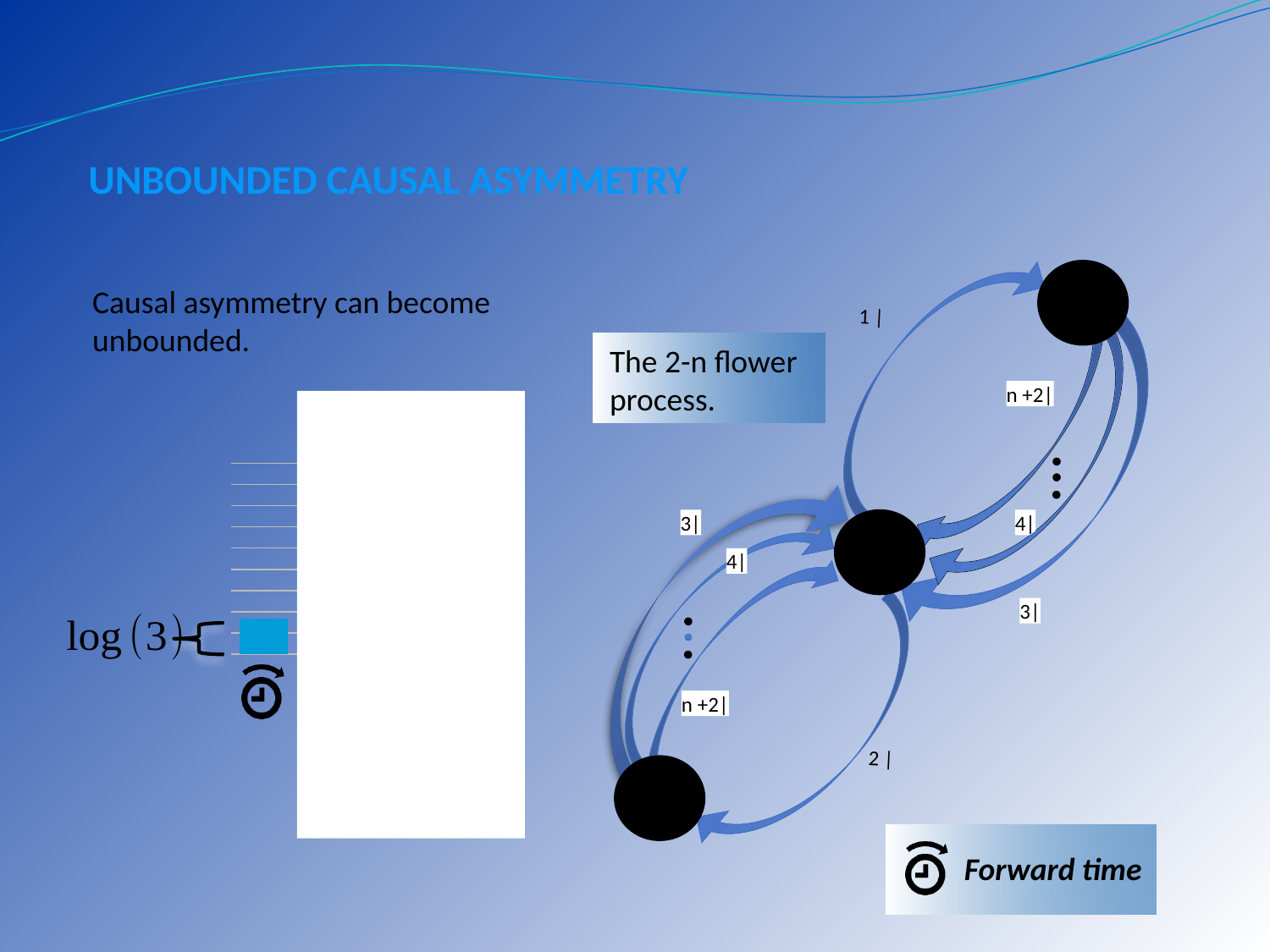
What colour is the visible bar in the left-hand bar chart? blue What value is the visible bar in the left-hand bar chart labelled with? log(3) Does the left-hand bar chart show a legend? No How many bars are visible in the bar chart on the left side of the slide? 1 What kind of chart is shown on the left side of the slide, next to the label log(3)? bar chart